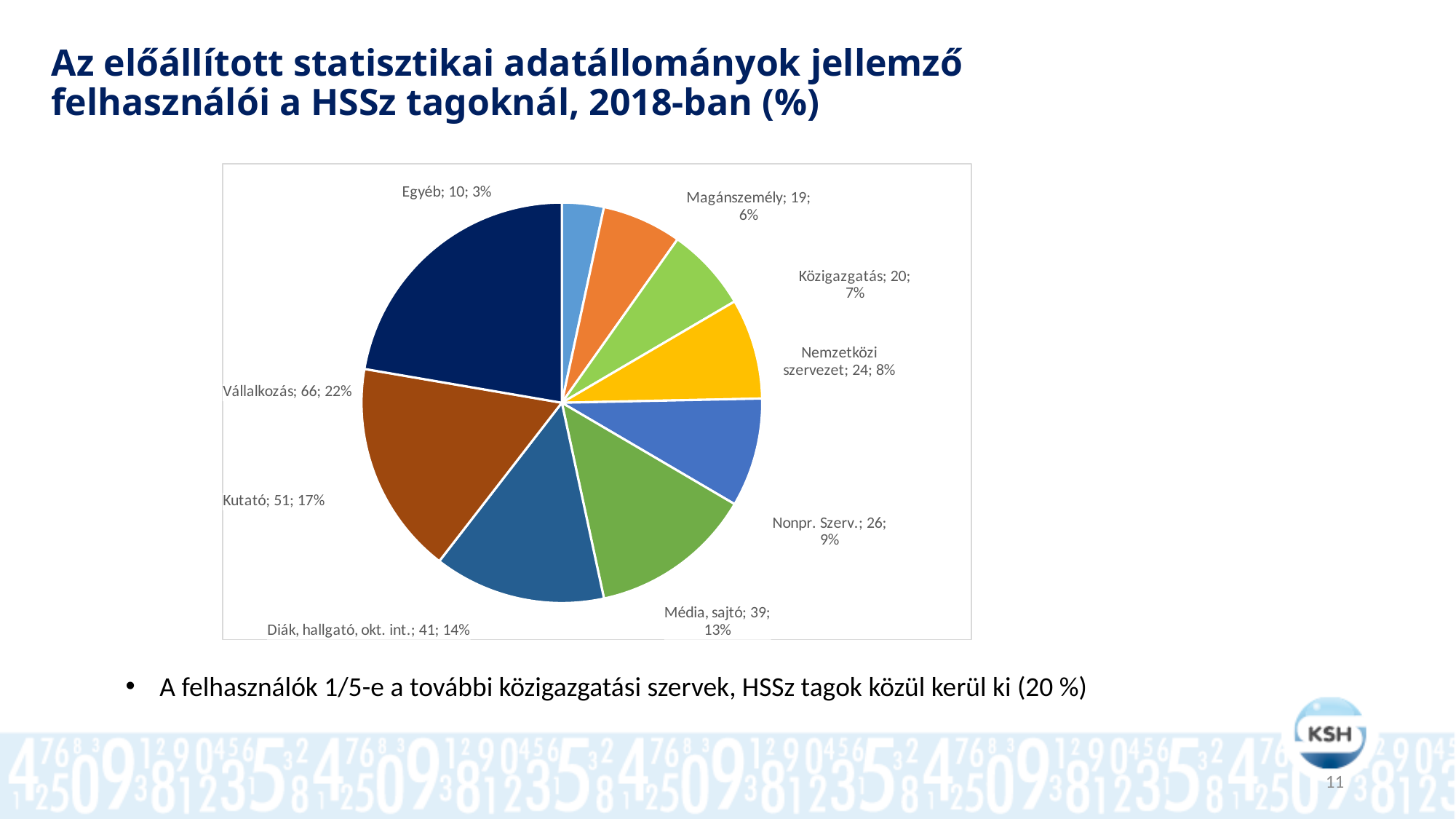
What year does the slide title say the data refers to? 2018 Which labelled category has the smallest slice of the pie? Egyéb What value is shown for the Vállalkozás slice? 66 What value is shown for the Kutató slice? 51 How many slices does the pie chart have? 9 Which labelled category has the largest slice of the pie? Vállalkozás What percentage share does the Média, sajtó slice have? 13% What percentage share does the Nemzetközi szervezet slice have? 8% What kind of chart is shown on the slide? pie chart What is the difference between the values for Vállalkozás and Kutató? 15 Which is larger, the value for Kutató or the value for Diák, hallgató, okt. int.? Kutató What value is shown for the Nonpr. Szerv. slice? 26